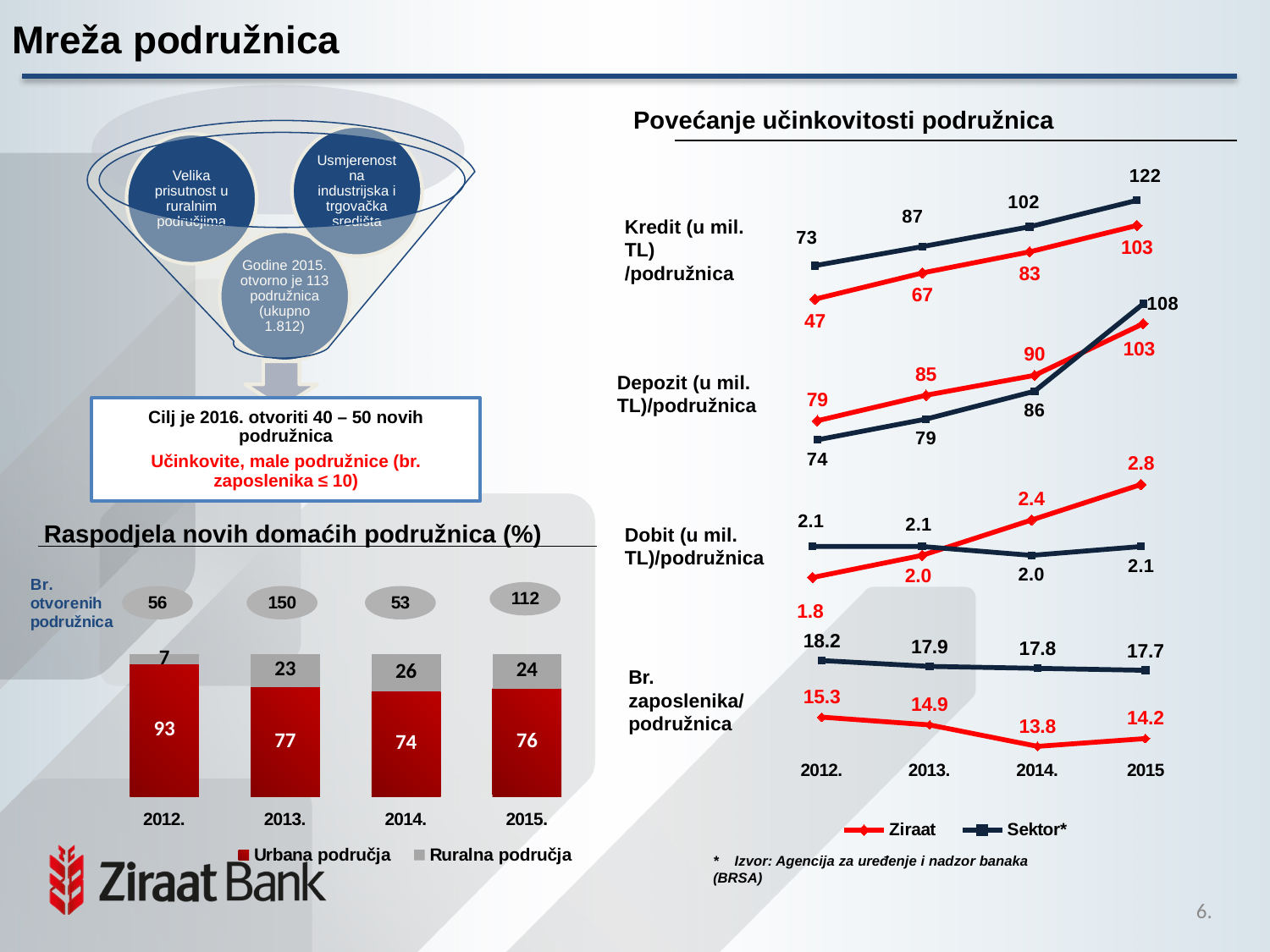
In the 'Povećanje učinkovitosti podružnica' chart, what is the Ziraat value for Br. zaposlenika/podružnica in 2014.? 13.8 In the 'Povećanje učinkovitosti podružnica' chart, what is the difference between the Sektor* and Ziraat values for Kredit (u mil. TL)/podružnica in 2012.? 26 In the 'Povećanje učinkovitosti podružnica' chart, what is the Ziraat value for Depozit (u mil. TL)/podružnica in 2013.? 85 In the 'Povećanje učinkovitosti podružnica' chart, which is larger for Dobit (u mil. TL)/podružnica in 2015: Ziraat or Sektor*? Ziraat In the 'Raspodjela novih domaćih podružnica (%)' chart, what is the value for Ruralna područja in 2014.? 26 In the 'Povećanje učinkovitosti podružnica' chart, does the Ziraat value for Dobit (u mil. TL)/podružnica rise or fall from 2012. to 2015? Rise In the 'Raspodjela novih domaćih podružnica (%)' chart, how many series does the legend list? 2 In the 'Raspodjela novih domaćih podružnica (%)' chart, what is the value for Urbana područja in 2012.? 93 In the 'Raspodjela novih domaćih podružnica (%)' chart, which year has the highest Urbana područja value? 2012. In the 'Raspodjela novih domaćih podružnica (%)' chart, what is the total of the stacked bar for 2015.? 100 In the 'Raspodjela novih domaćih podružnica (%)' chart, what type of chart is shown? Stacked bar chart In the 'Povećanje učinkovitosti podružnica' chart, what is the Sektor* value for Kredit (u mil. TL)/podružnica in 2015? 122